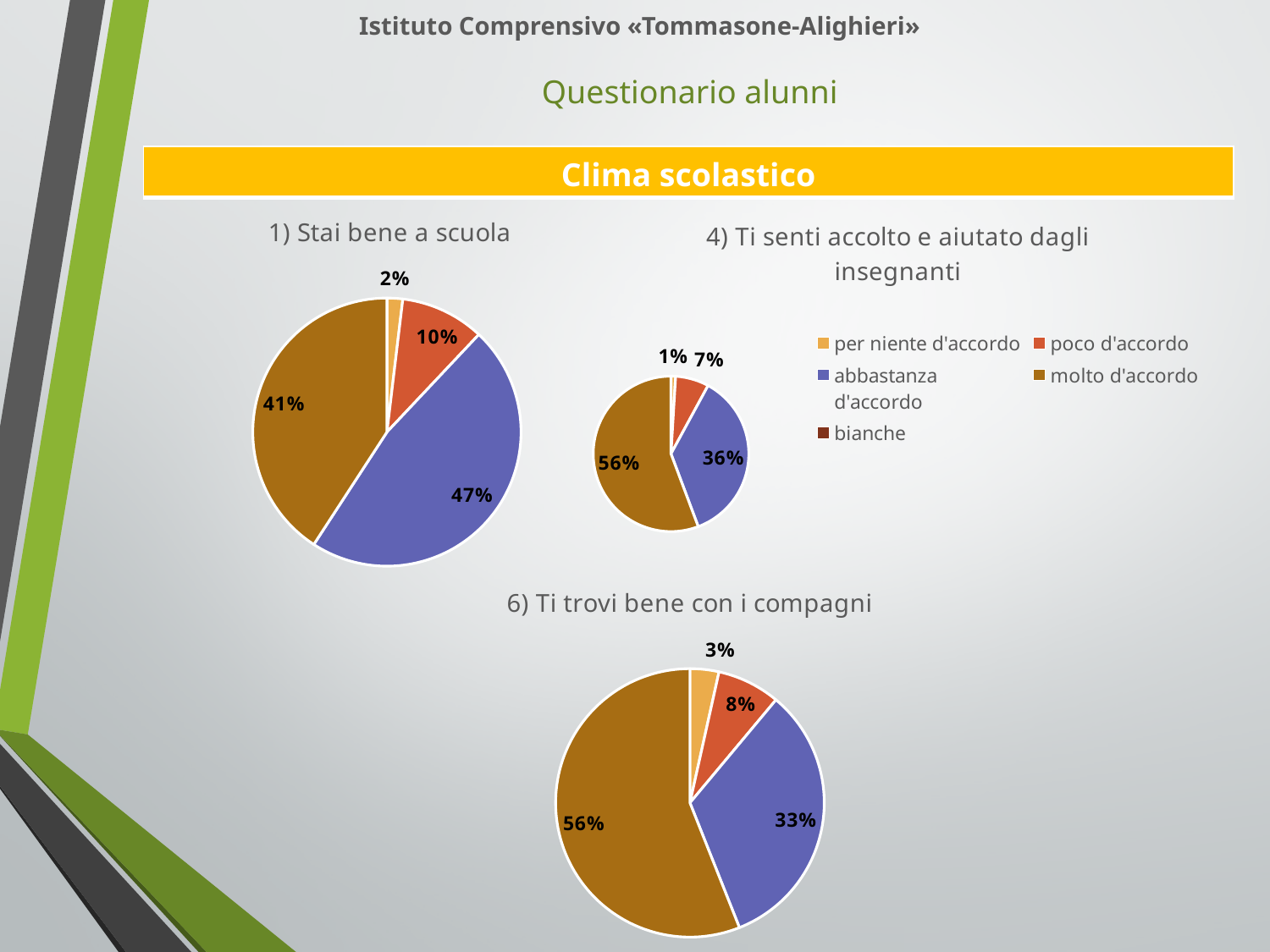
In the chart "1) Stai bene a scuola", which response has the largest slice? abbastanza d'accordo In the chart "4) Ti senti accolto e aiutato dagli insegnanti", what percentage is shown for "molto d'accordo"? 56% In the chart "6) Ti trovi bene con i compagni", what is the combined share of "molto d'accordo" and "abbastanza d'accordo"? 89% In the chart "1) Stai bene a scuola", what percentage is shown for "abbastanza d'accordo"? 47% What kind of chart is used for "1) Stai bene a scuola"? pie chart How many entries does the legend on the slide list? 5 In the chart "4) Ti senti accolto e aiutato dagli insegnanti", what is the difference between the "molto d'accordo" and "abbastanza d'accordo" slices? 20% In the chart "1) Stai bene a scuola", which response has the smallest slice? per niente d'accordo In the chart "1) Stai bene a scuola", what percentage is shown for "poco d'accordo"? 10% In the chart "6) Ti trovi bene con i compagni", what percentage is shown for "abbastanza d'accordo"? 33% In the chart "4) Ti senti accolto e aiutato dagli insegnanti", which is larger, "poco d'accordo" or "per niente d'accordo"? poco d'accordo In the chart "6) Ti trovi bene con i compagni", which response has the largest slice? molto d'accordo